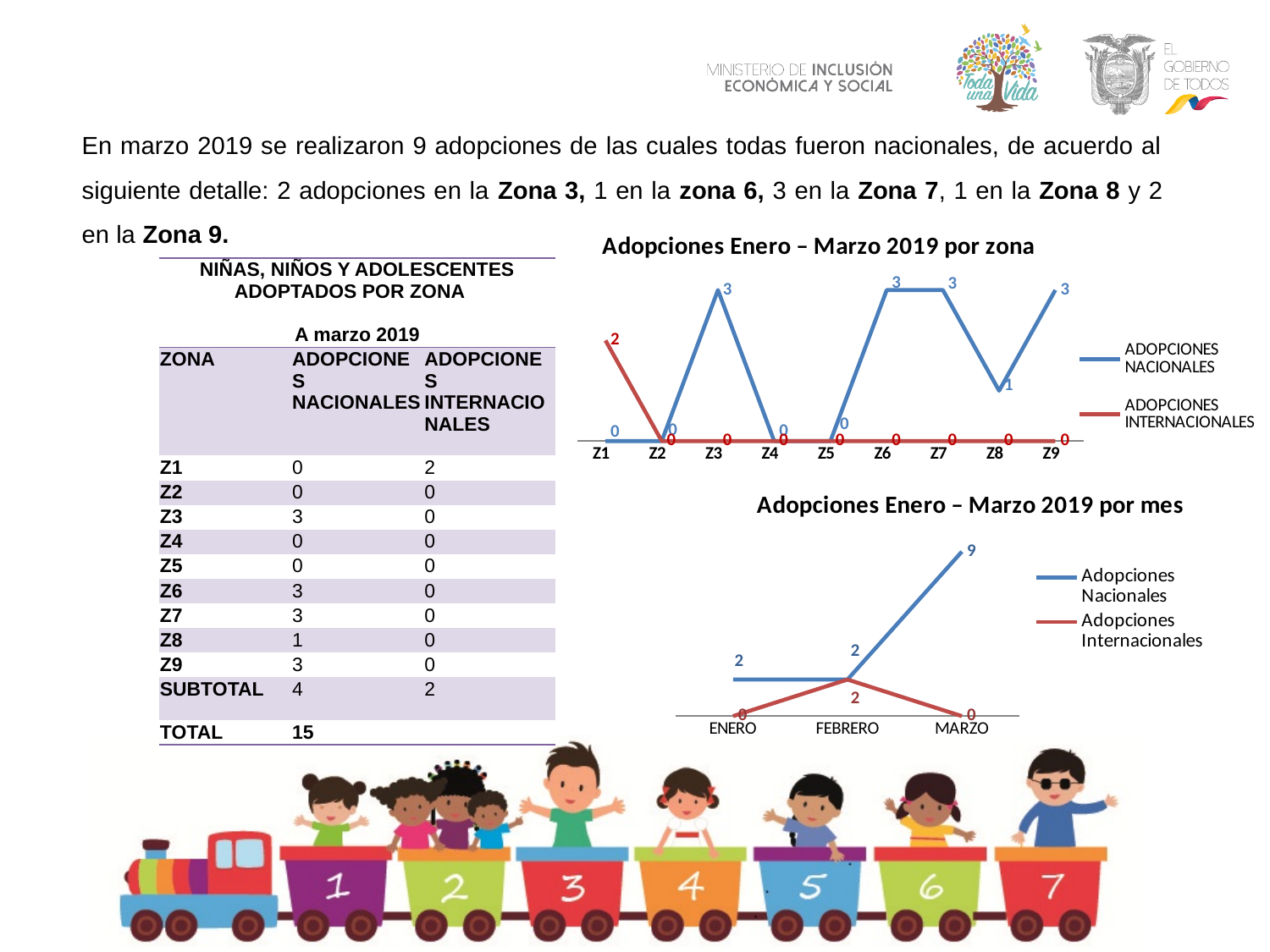
In the chart 'Adopciones Enero – Marzo 2019 por mes', what is the value of Adopciones Internacionales for FEBRERO? 2 In the chart 'Adopciones Enero – Marzo 2019 por mes', what is the value of Adopciones Nacionales for MARZO? 9 What kind of chart is 'Adopciones Enero – Marzo 2019 por zona'? Line chart In the chart 'Adopciones Enero – Marzo 2019 por zona', how many series does the legend list? 2 In the chart 'Adopciones Enero – Marzo 2019 por zona', which zone has the highest value for ADOPCIONES INTERNACIONALES? Z1 In the chart 'Adopciones Enero – Marzo 2019 por mes', what is the difference between Adopciones Nacionales in MARZO and in FEBRERO? 7 In the chart 'Adopciones Enero – Marzo 2019 por mes', which month has the highest value for Adopciones Nacionales? MARZO In the chart 'Adopciones Enero – Marzo 2019 por zona', what is the value of ADOPCIONES NACIONALES for Z3? 3 In the chart 'Adopciones Enero – Marzo 2019 por zona', what is the value of ADOPCIONES INTERNACIONALES for Z1? 2 In the chart 'Adopciones Enero – Marzo 2019 por mes', does the Adopciones Nacionales line rise or fall from FEBRERO to MARZO? Rise In the chart 'Adopciones Enero – Marzo 2019 por zona', how many zones are shown on the x axis? 9 In the chart 'Adopciones Enero – Marzo 2019 por zona', what is the value of ADOPCIONES NACIONALES for Z8? 1